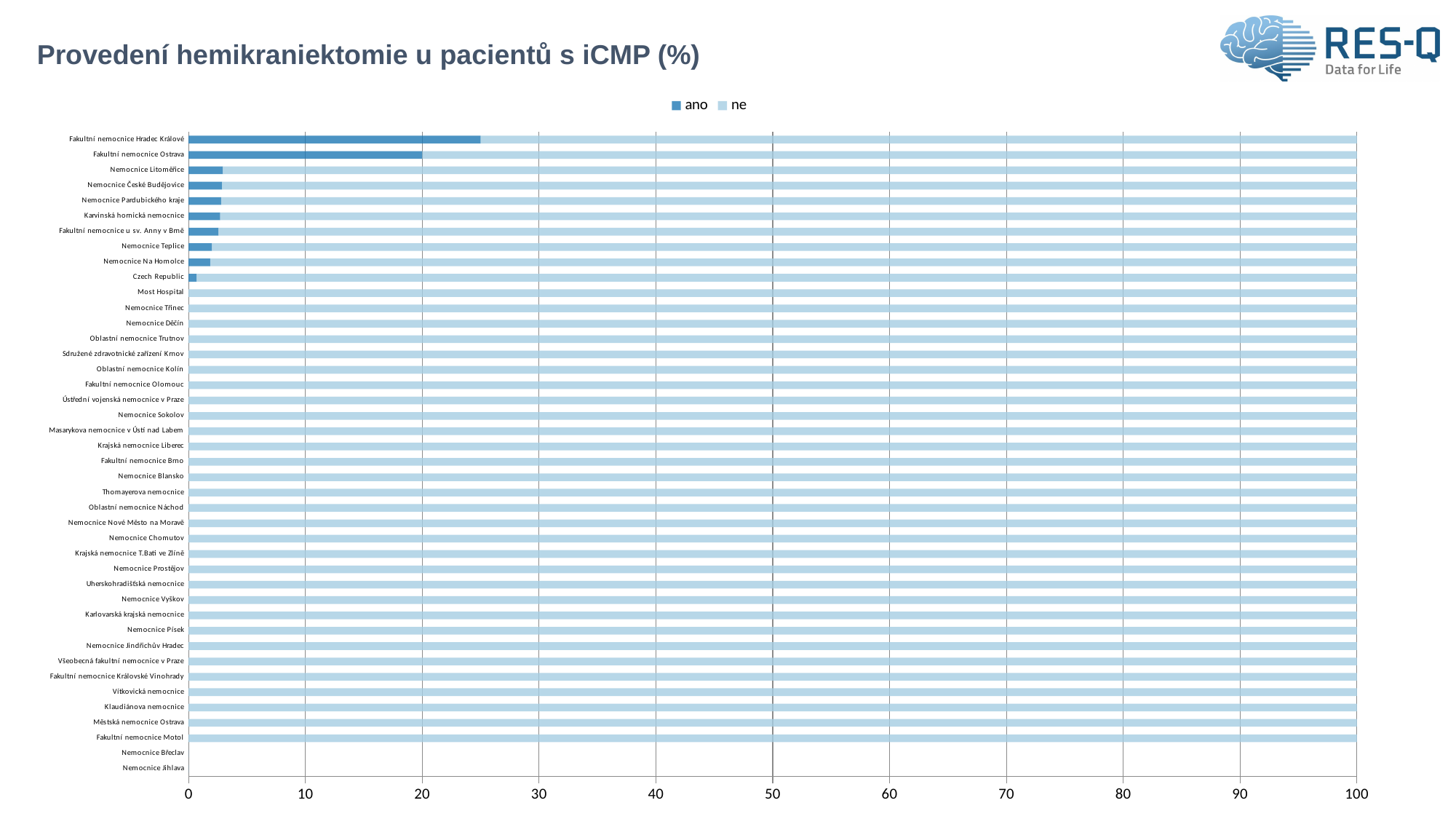
Is the 'ano' value for Fakultní nemocnice Ostrava greater or less than 30? less Is the 'ano' value for Fakultní nemocnice Hradec Králové greater or less than 20? greater What are the two series named in the legend? ano, ne Which has the larger 'ano' value, Fakultní nemocnice Hradec Králové or Fakultní nemocnice Ostrava? Fakultní nemocnice Hradec Králové What kind of chart is shown on the slide? stacked bar chart What is the total of the stacked bar for Fakultní nemocnice Motol? 100 Is the 'ano' value for Fakultní nemocnice Ostrava greater or less than 10? greater What is the title of the chart? Provedení hemikraniektomie u pacientů s iCMP (%) How many series does the legend list? 2 How many hospitals/categories are listed on the vertical axis? 42 Which hospital has the highest value for the 'ano' series? Fakultní nemocnice Hradec Králové